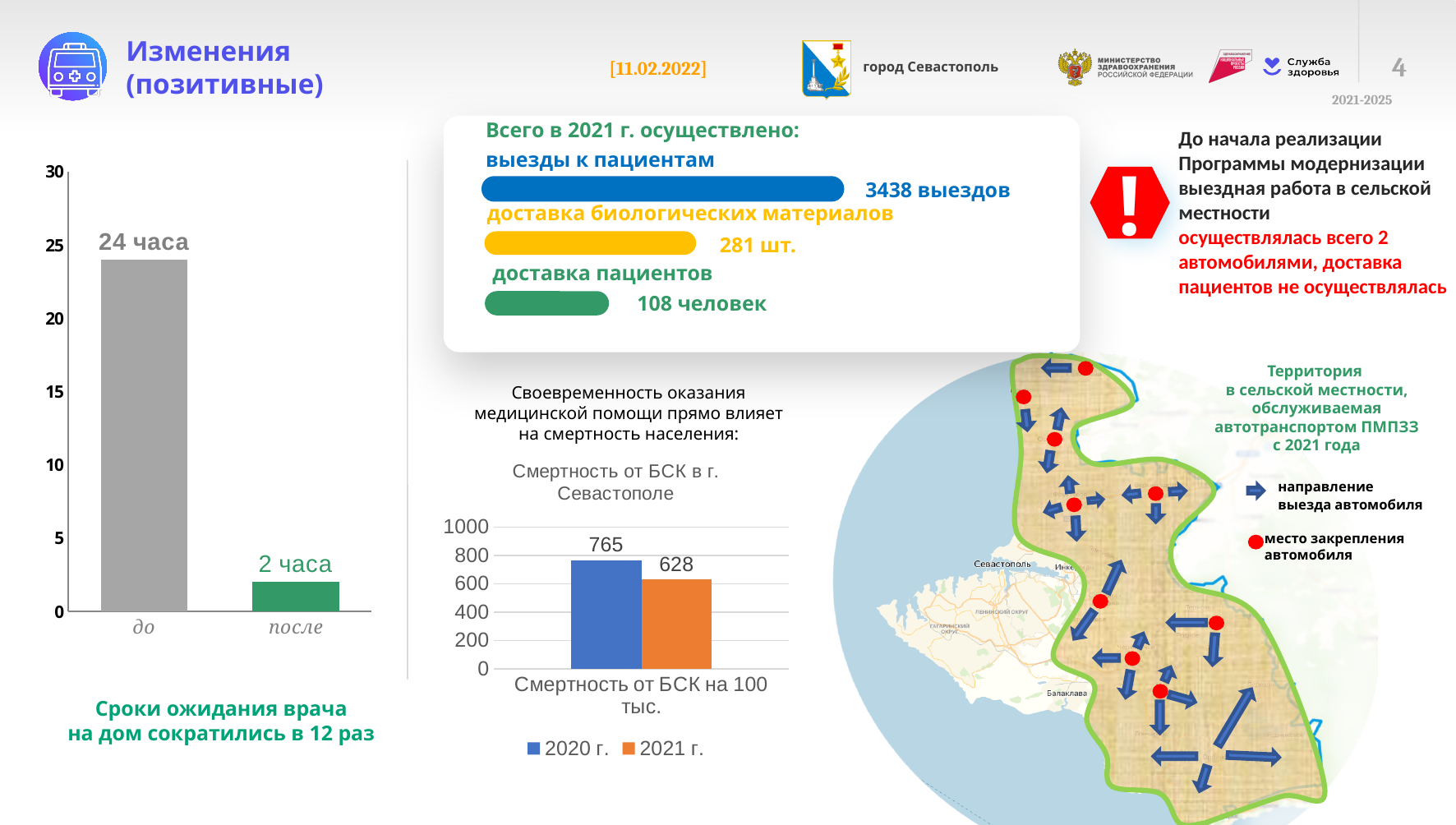
On the left chart, is the value for "до" greater or less than 20? greater On the chart "Смертность от БСК в г. Севастополе", which series is shown in orange? 2021 г. On the chart "Смертность от БСК в г. Севастополе", what is the value for 2021 г.? 628 On the left chart, which category has the higher value, "до" or "после"? до On the chart "Смертность от БСК в г. Севастополе", what is the difference between the 2020 г. and 2021 г. values? 137 On the chart "Смертность от БСК в г. Севастополе", what is the value for 2020 г.? 765 How many series does the legend of the chart "Смертность от БСК в г. Севастополе" list? 2 On the left chart, by how many hours does the value for "до" exceed the value for "после"? 22 часа How many categories are shown on the left chart? 2 What kind of chart is the left chart? bar chart On the left chart, what is the value for "после"? 2 часа On the left chart, what is the value for "до"? 24 часа